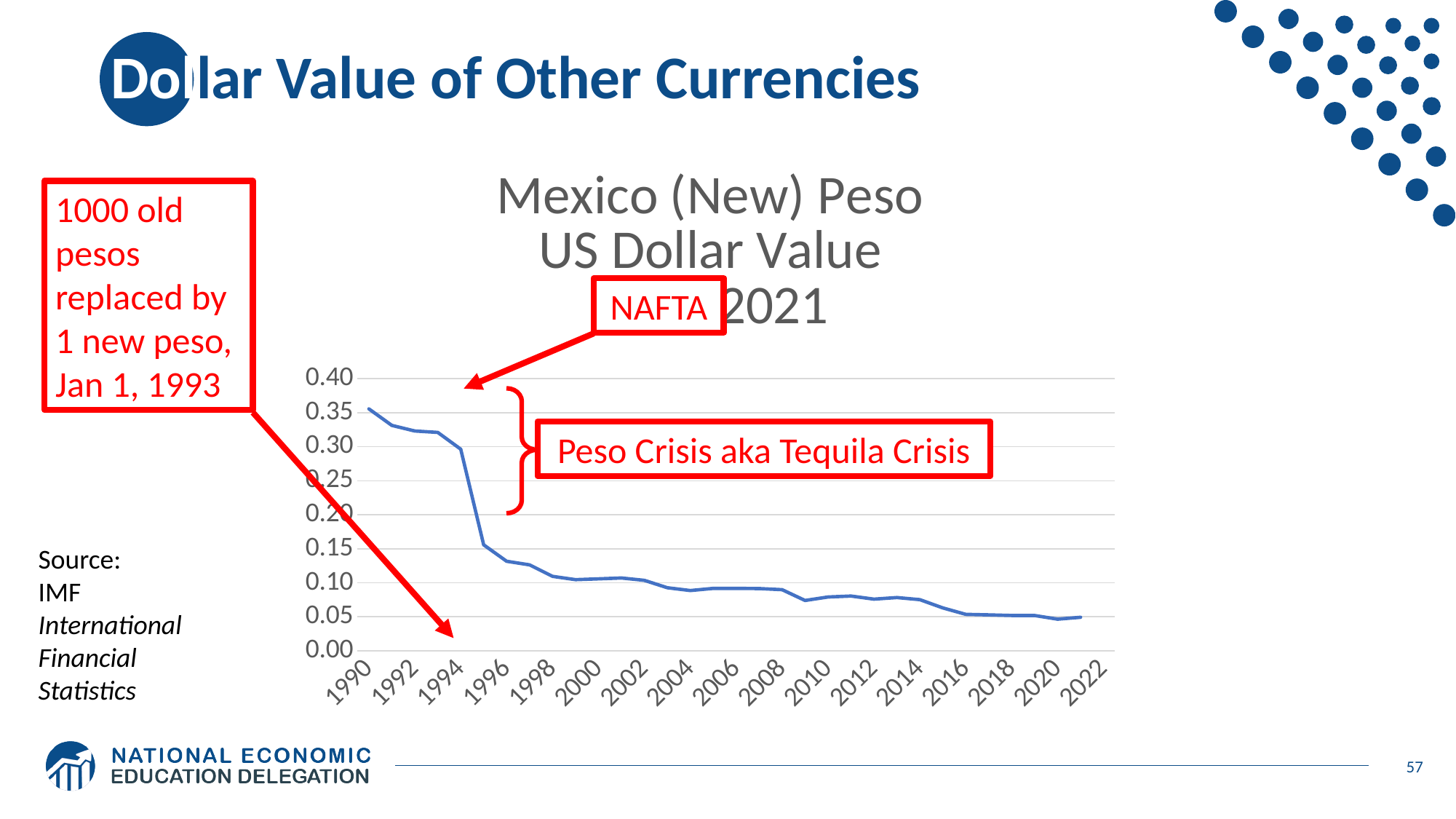
Overall, does the US dollar value of the Mexican peso rise or fall from 1990 to 2021? fall Which year has the larger value, 1994 or 1996? 1994 What is the title of the chart? Mexico (New) Peso US Dollar Value 1990-2021 Is the value for 1990 greater or less than 0.30? greater Is the value for 1996 greater or less than 0.20? less What kind of chart is shown on the slide? line chart Is the value for 1994 greater or less than 0.25? greater How many year labels are shown on the x axis? 17 Which year has the larger value, 1990 or 2000? 1990 In which year is the US dollar value of the peso highest? 1990